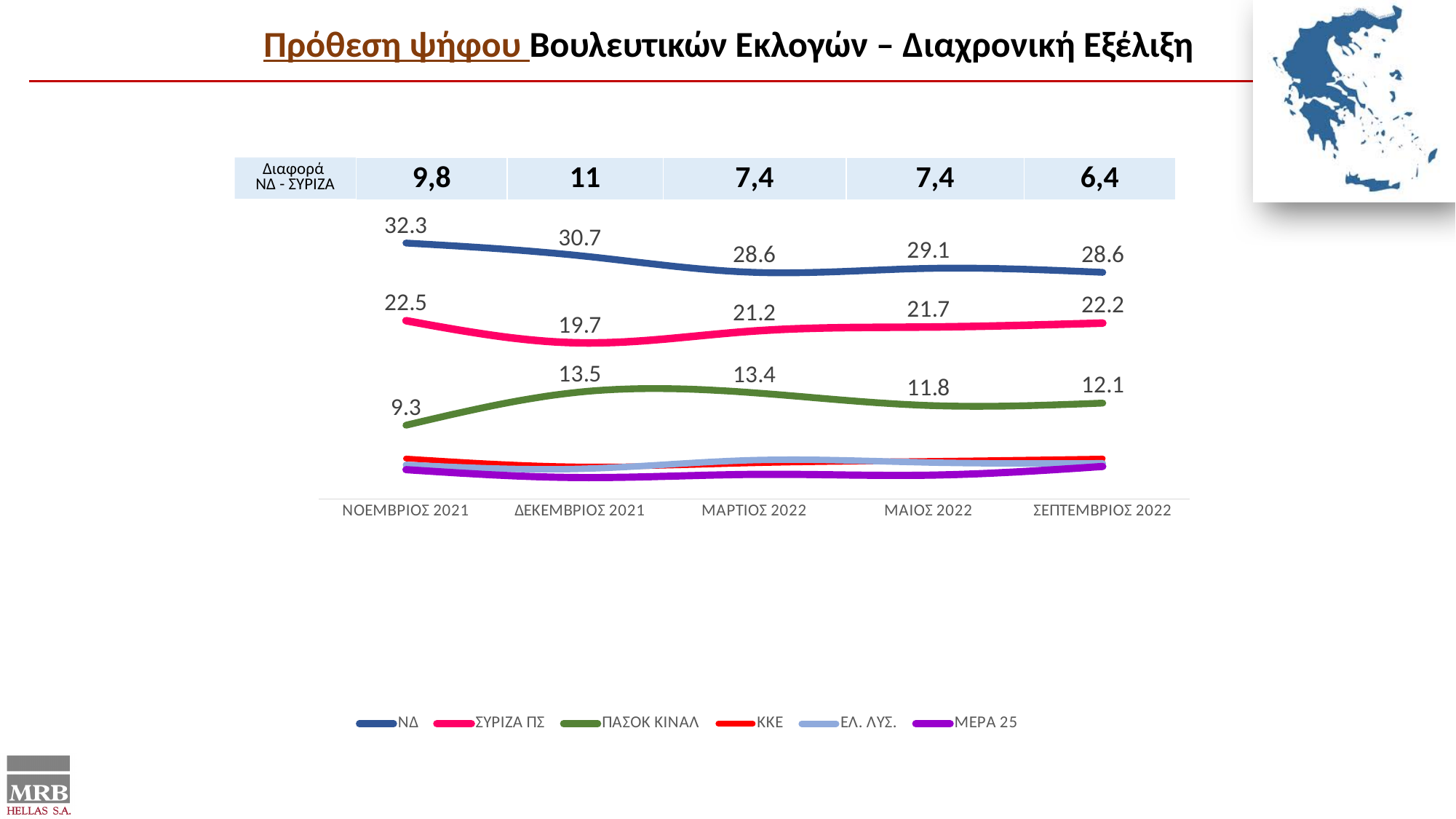
What is the value for ΠΑΣΟΚ ΚΙΝΑΛ in ΜΑΡΤΙΟΣ 2022? 13.4 What is the difference between ΝΔ and ΣΥΡΙΖΑ ΠΣ in ΣΕΠΤΕΜΒΡΙΟΣ 2022? 6.4 In which period does ΠΑΣΟΚ ΚΙΝΑΛ have its lowest value? ΝΟΕΜΒΡΙΟΣ 2021 What kind of chart is shown on the slide? Line chart How many series does the legend list? 6 How many time periods are shown on the x axis? 5 Does the value for ΝΔ rise or fall from ΝΟΕΜΒΡΙΟΣ 2021 to ΜΑΡΤΙΟΣ 2022? Fall In which period does ΝΔ reach its highest value? ΝΟΕΜΒΡΙΟΣ 2021 What colour is the line for ΠΑΣΟΚ ΚΙΝΑΛ? Green What is the value for ΝΔ in ΝΟΕΜΒΡΙΟΣ 2021? 32.3 Which is larger for ΣΥΡΙΖΑ ΠΣ: the value in ΜΑΙΟΣ 2022 or in ΣΕΠΤΕΜΒΡΙΟΣ 2022? ΣΕΠΤΕΜΒΡΙΟΣ 2022 What is the value for ΣΥΡΙΖΑ ΠΣ in ΔΕΚΕΜΒΡΙΟΣ 2021? 19.7